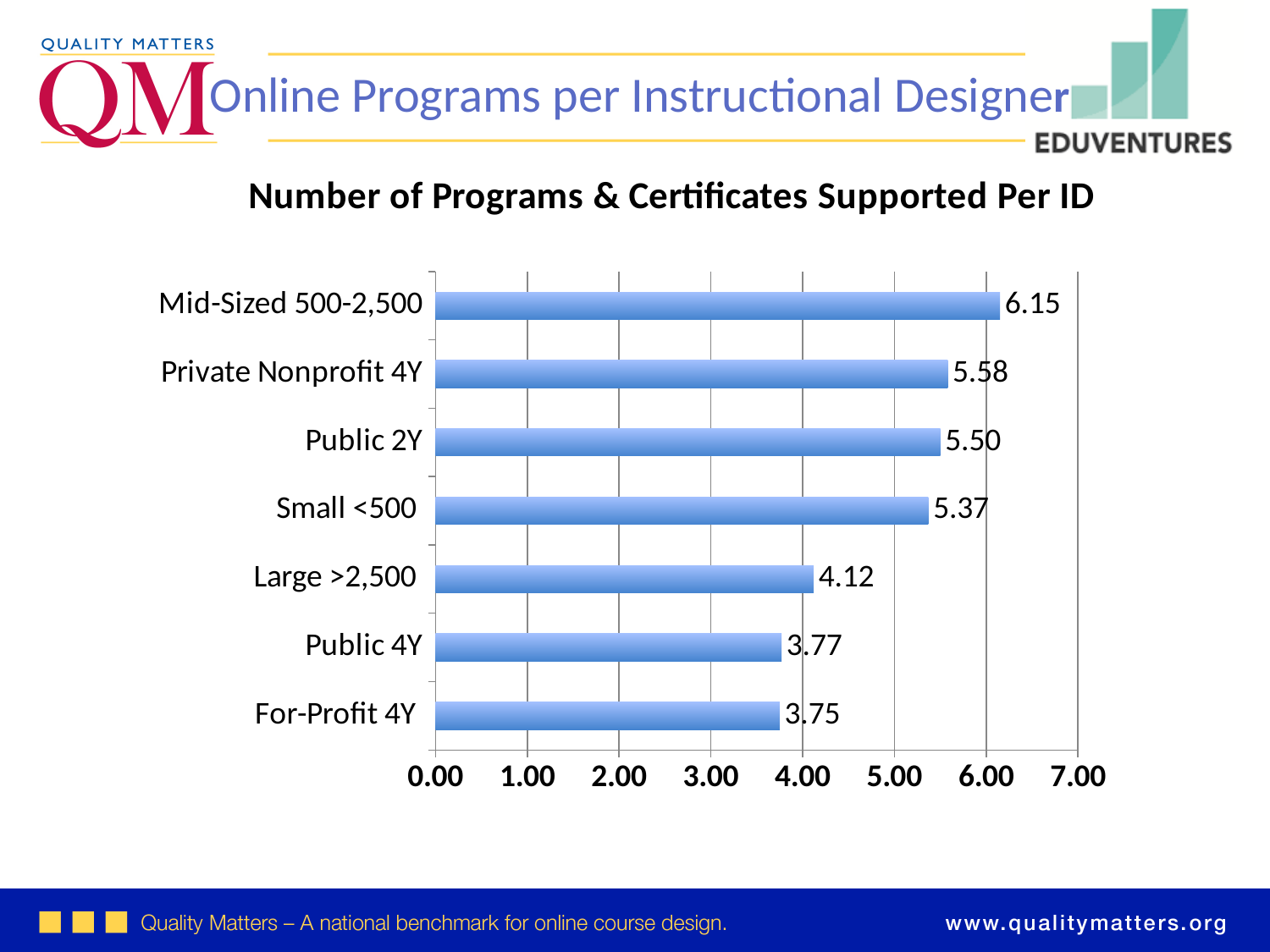
What is the value for Large >2,500? 4.12 What is the title of the chart? Number of Programs & Certificates Supported Per ID What kind of chart is shown on the slide? bar chart Which is larger, the value for Small <500 or the value for Public 4Y? Small <500 What is the difference between the values for Private Nonprofit 4Y and Small <500? 0.21 Which category has the highest value? Mid-Sized 500-2,500 Is the value for Private Nonprofit 4Y greater or less than 5.00? greater Which category has the lowest value? For-Profit 4Y How many categories are shown in the chart? 7 What is the difference between the values for Mid-Sized 500-2,500 and Large >2,500? 2.03 What is the value for Public 2Y? 5.50 What is the value for Mid-Sized 500-2,500? 6.15